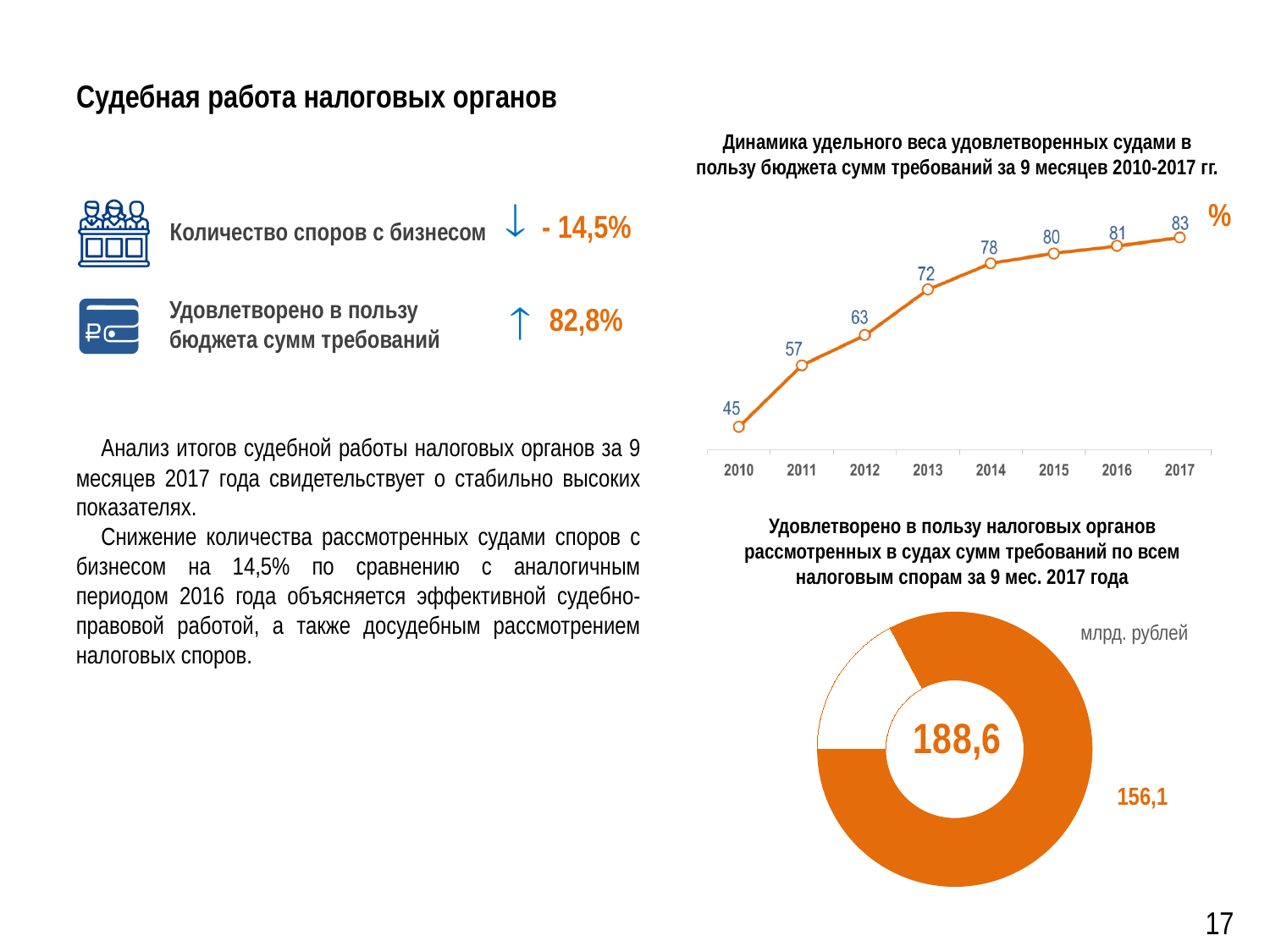
In the line chart at the top right, which year has the lowest value? 2010 In the line chart at the top right, do the values rise or fall from 2010 to 2017? rise In the line chart at the top right, which year has the larger value, 2012 or 2014? 2014 In the line chart at the top right, what is the difference between the values for 2017 and 2010? 38 In the donut chart at the bottom right, what total value is shown in the centre? 188,6 In the donut chart at the bottom right, what value is labelled on the orange slice? 156,1 In the line chart at the top right, which year has the highest value? 2017 In the line chart at the top right, what is the value for 2013? 72 In the line chart at the top right, what is the value for 2017? 83 In the line chart titled "Динамика удельного веса удовлетворенных судами в пользу бюджета сумм требований", what is the value for 2010? 45 What kind of chart is shown at the bottom right of the slide? Donut (pie) chart How many data points are plotted in the line chart at the top right? 8